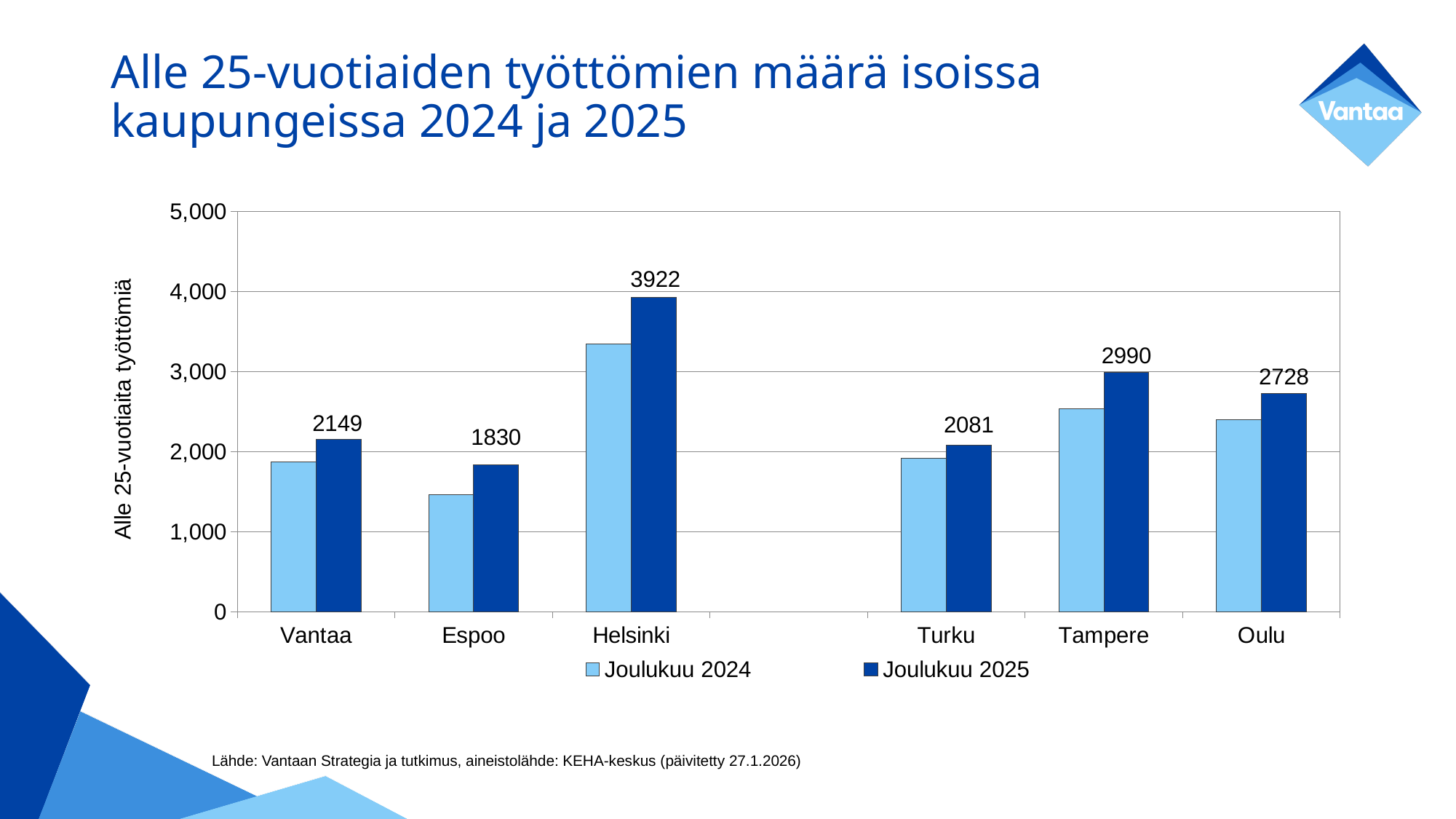
Is the Joulukuu 2024 value for Vantaa greater or less than 2,000? less What is the difference between the Joulukuu 2025 values for Helsinki and Tampere? 932 How many series does the legend list? 2 Which city has the highest value in the Joulukuu 2025 series? Helsinki What kind of chart is shown on the slide? bar chart Which city has the lowest value in the Joulukuu 2025 series? Espoo What is the value for Espoo in the Joulukuu 2025 series? 1830 How many cities are shown on the x axis of the chart? 6 What is the difference between the Joulukuu 2025 values for Vantaa and Turku? 68 Is the Joulukuu 2024 value for Helsinki greater or less than 3,000? greater What is the value for Helsinki in the Joulukuu 2025 series? 3922 In the Joulukuu 2025 series, which is larger: Tampere or Oulu? Tampere